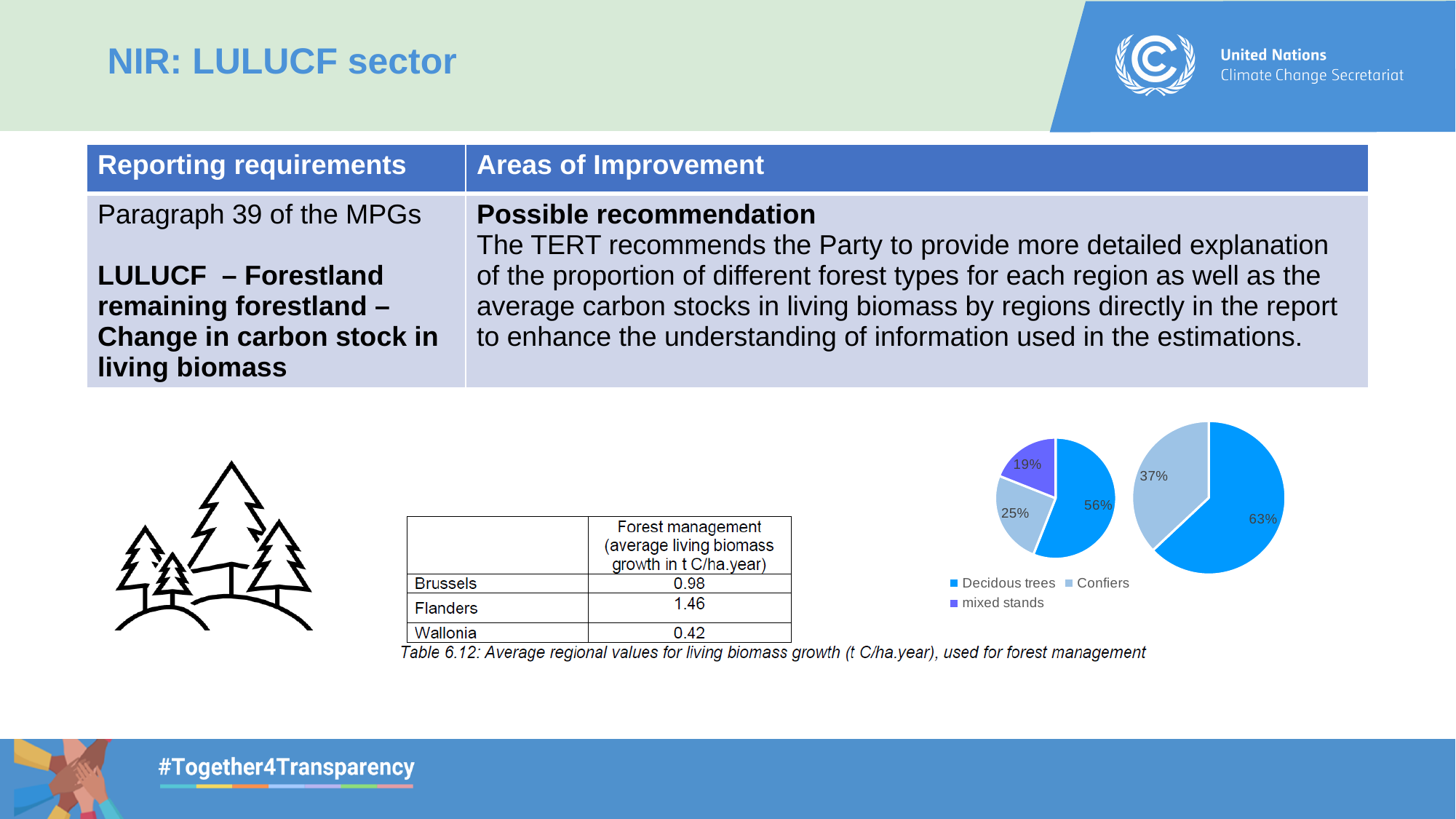
In the right pie chart, what share is shown for Conifers? 37% In the left pie chart, what share is shown for Conifers? 25% In the left pie chart, what share is shown for mixed stands? 19% How many entries does the legend below the pie charts list? 3 In the left pie chart, which category has the smallest slice? mixed stands In the left pie chart, what is the difference in percentage points between Deciduous trees and Conifers? 31 percentage points In the right pie chart, which is larger, Deciduous trees or Conifers? Deciduous trees What type of chart are the two charts on the right side of the slide? Pie chart How many slices does the left pie chart have? 3 In the left pie chart, which category has the largest slice? Deciduous trees